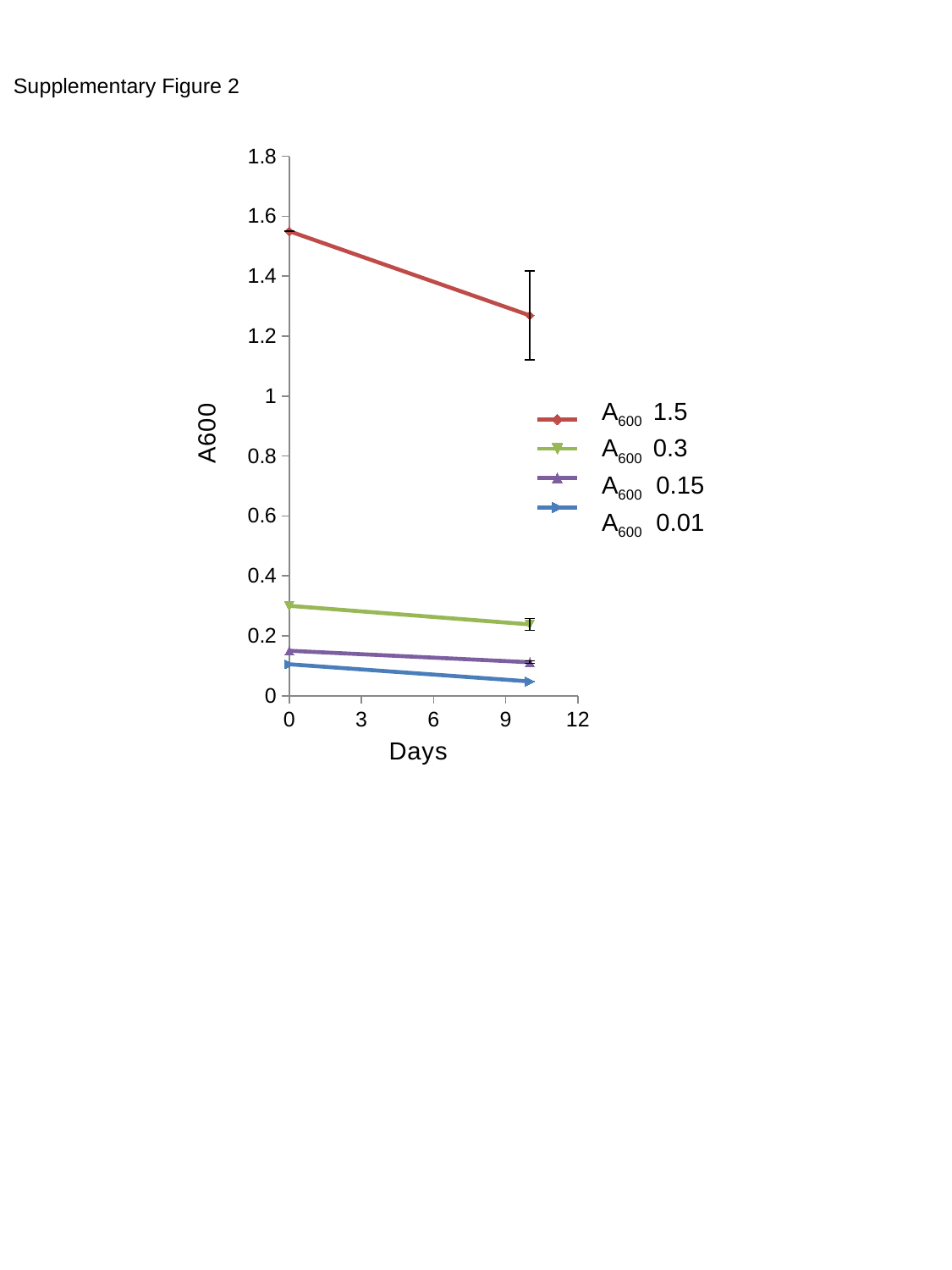
What kind of chart is shown on the slide? line chart Is the value for the A600 1.5 series at day 0 greater or less than 1.4? greater Does the A600 0.01 series rise or fall along the x axis? fall Is the value for the A600 0.01 series at day 10 greater or less than 0.2? less What is the title of the x axis? Days How many data points are plotted for the A600 1.5 series? 2 How many series does the legend list? 4 Is the value for the A600 1.5 series at day 10 greater or less than 1.4? less Which series has the highest values on the chart? A600 1.5 Which series has the lowest values on the chart? A600 0.01 Which is larger at day 10: the value for A600 0.3 or the value for A600 0.15? A600 0.3 Does the A600 1.5 series rise or fall from day 0 to day 10? fall